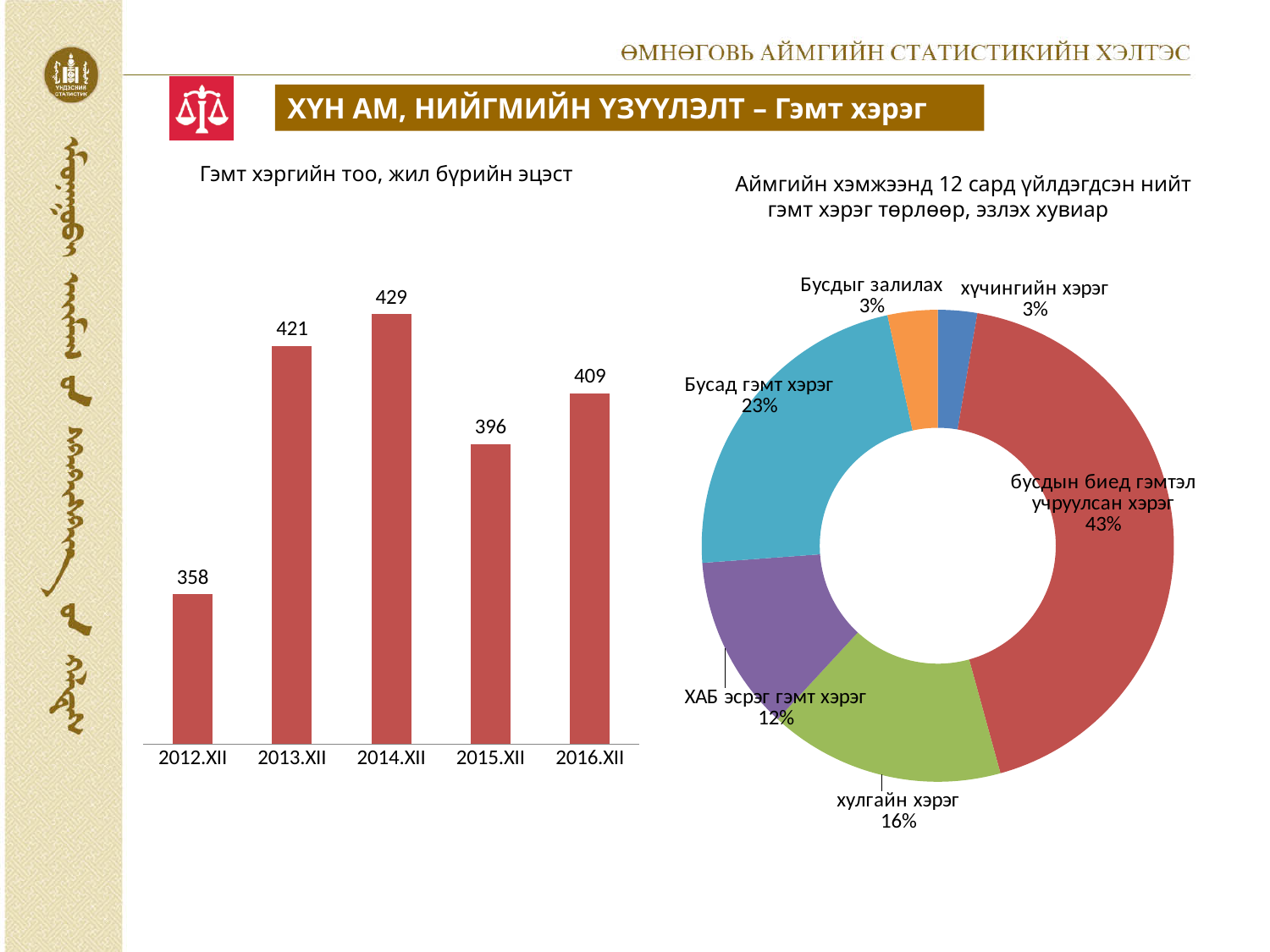
In the bar chart 'Гэмт хэргийн тоо, жил бүрийн эцэст', what is the difference between the values for 2014.XII and 2015.XII? 33 In the doughnut chart on the right, what share does 'бусдын биед гэмтэл учруулсан хэрэг' have? 43% In the bar chart 'Гэмт хэргийн тоо, жил бүрийн эцэст', what is the value for 2014.XII? 429 How many bars are in the bar chart 'Гэмт хэргийн тоо, жил бүрийн эцэст'? 5 What kind of chart is the chart on the left of the slide? Bar chart In the doughnut chart on the right, what share does 'хулгайн хэрэг' have? 16% In the doughnut chart on the right, which category has the largest share? бусдын биед гэмтэл учруулсан хэрэг How many slices does the doughnut chart on the right have? 6 In the bar chart 'Гэмт хэргийн тоо, жил бүрийн эцэст', which year has the highest value? 2014.XII In the bar chart 'Гэмт хэргийн тоо, жил бүрийн эцэст', what is the value for 2012.XII? 358 In the bar chart 'Гэмт хэргийн тоо, жил бүрийн эцэст', which year has the lowest value? 2012.XII In the bar chart 'Гэмт хэргийн тоо, жил бүрийн эцэст', which is larger: the value for 2013.XII or 2016.XII? 2013.XII